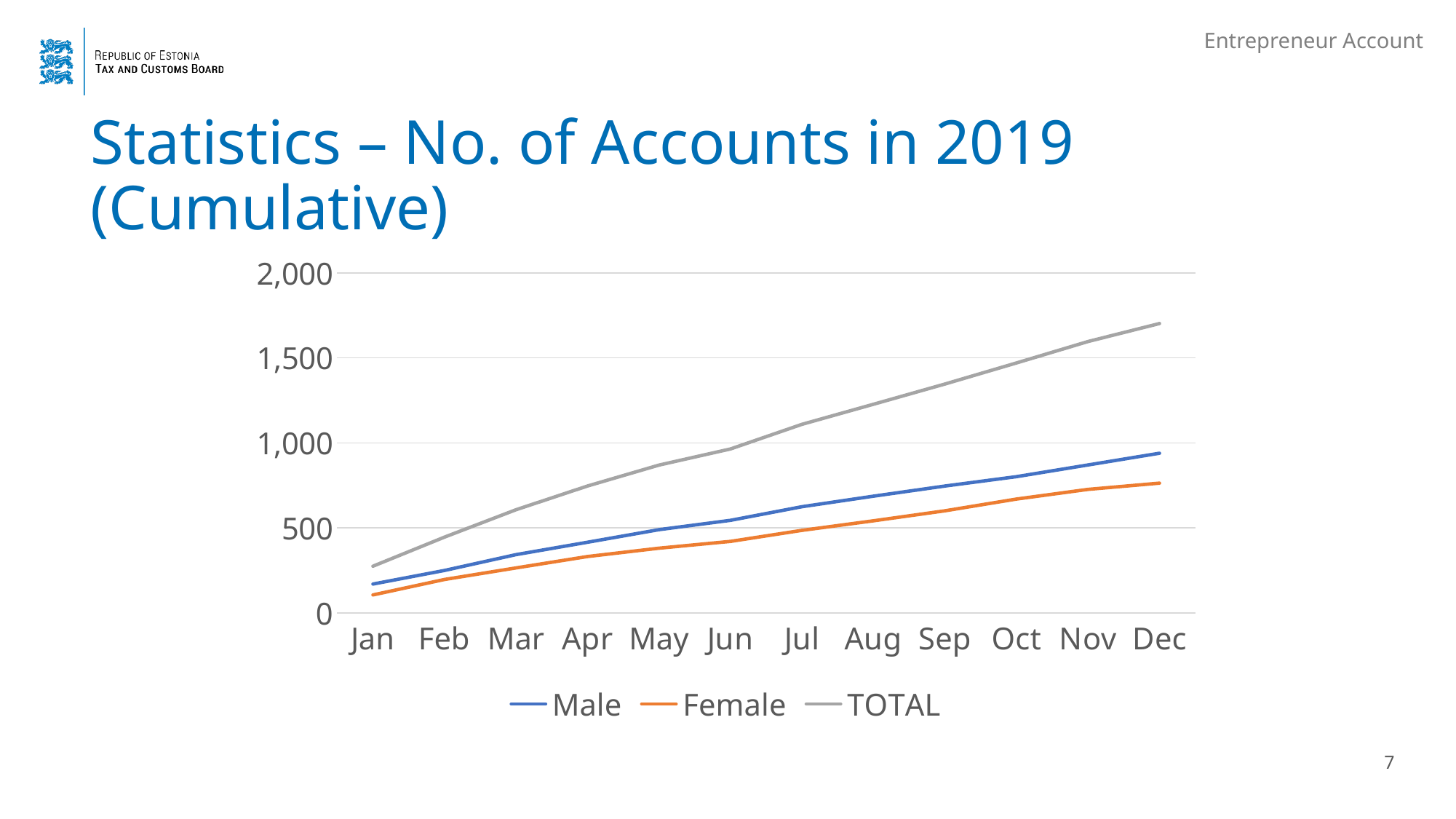
Which series has the higher value in Dec, Male or Female? Male In which month does the TOTAL series reach its highest value? Dec Is the value for Male in Dec greater or less than 1,000? less Is the value for Female in Dec greater or less than 500? greater How many months are plotted along the x axis? 12 Do the values for the TOTAL series rise or fall from Jan to Dec? rise How many series does the legend list? 3 Is the value for TOTAL in Sep greater or less than 1,000? greater What kind of chart is shown on the slide? line chart What is the title of the slide containing the chart? Statistics – No. of Accounts in 2019 (Cumulative)